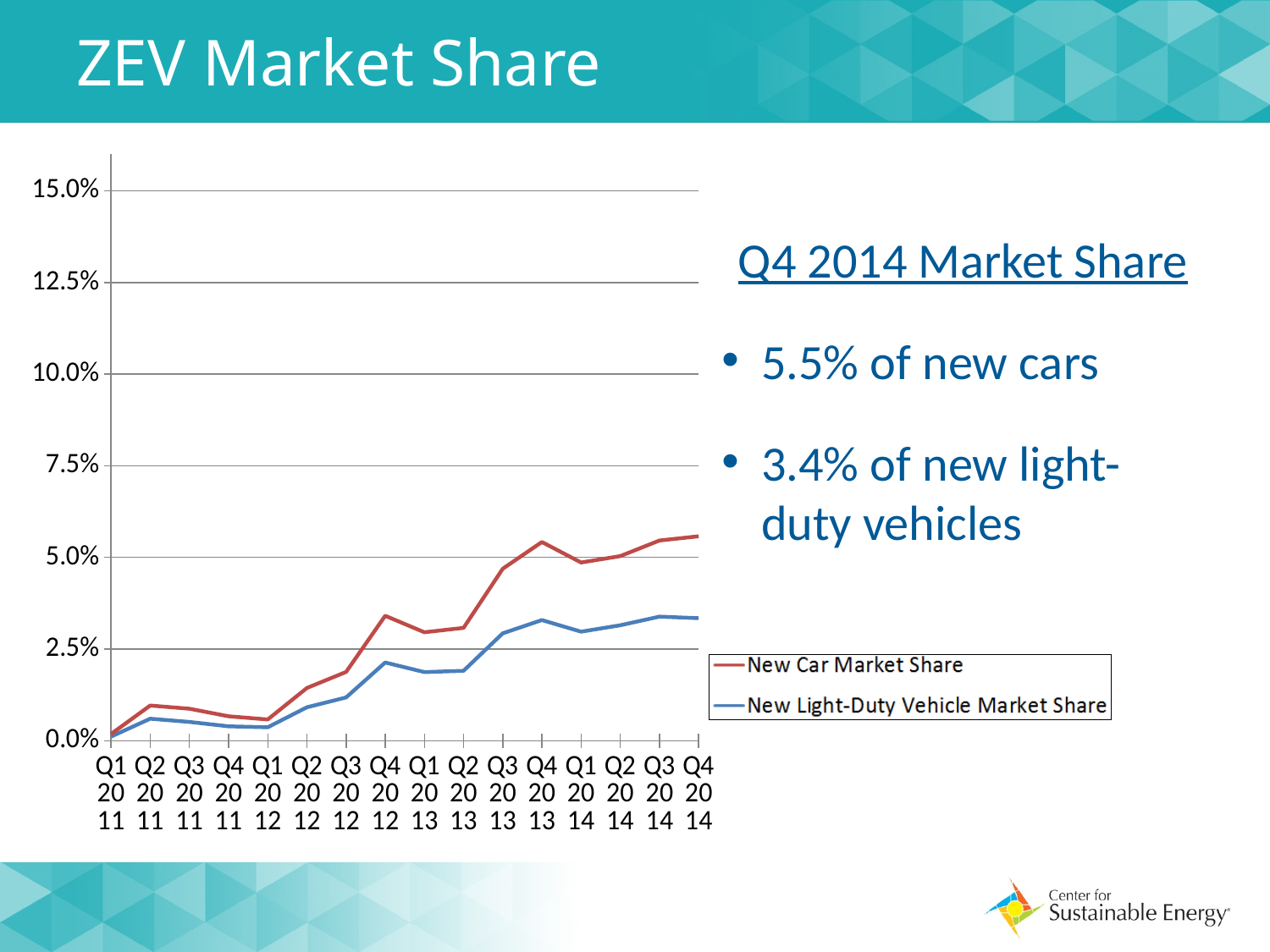
What is the New Car Market Share value for Q4 2014? 5.5% How many quarters are plotted along the x axis of the chart? 16 What colour is the line for New Light-Duty Vehicle Market Share? blue Is the New Car Market Share for Q4 2013 greater or less than 5.0%? greater What is the difference between the New Car Market Share and the New Light-Duty Vehicle Market Share in Q4 2014? 2.1% What kind of chart is shown on the slide? line chart Which series is higher in Q4 2014, New Car Market Share or New Light-Duty Vehicle Market Share? New Car Market Share Is the New Light-Duty Vehicle Market Share for Q4 2012 greater or less than 2.5%? less What is the New Light-Duty Vehicle Market Share value for Q4 2014? 3.4% How many series does the chart's legend list? 2 In which quarter is the New Car Market Share lowest? Q1 2011 Overall, do the market share values rise or fall from Q1 2011 to Q4 2014? rise